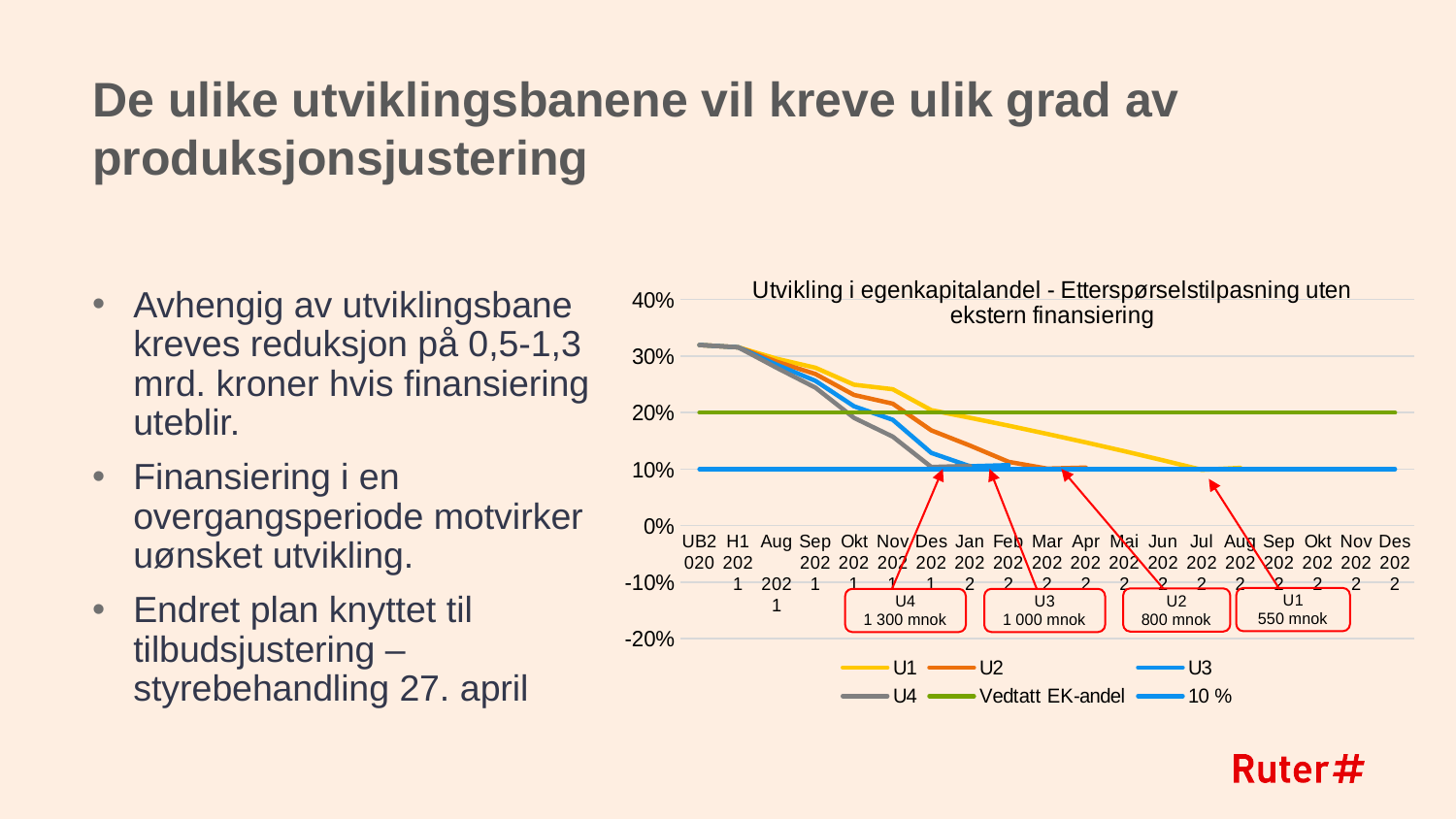
Is the value for U1 in Mar 2022 greater or less than 10%? greater How many series does the chart legend list? 6 Does the U1 line rise or fall from UB2 2020 to Jul 2022? fall In Des 2021, which is higher, U1 or U4? U1 What is the title of the chart? Utvikling i egenkapitalandel - Etterspørselstilpasning uten ekstern finansiering How many time periods are shown on the x axis of the chart? 19 What amount is shown in the annotation box for U2? 800 mnok What type of chart is shown on the slide? line chart What amount is shown in the annotation box for U1? 550 mnok Is the value for U4 in Nov 2021 greater or less than 20%? less What amount is shown in the annotation box for U4? 1 300 mnok At what level does the Vedtatt EK-andel line stay across the whole chart? 20%